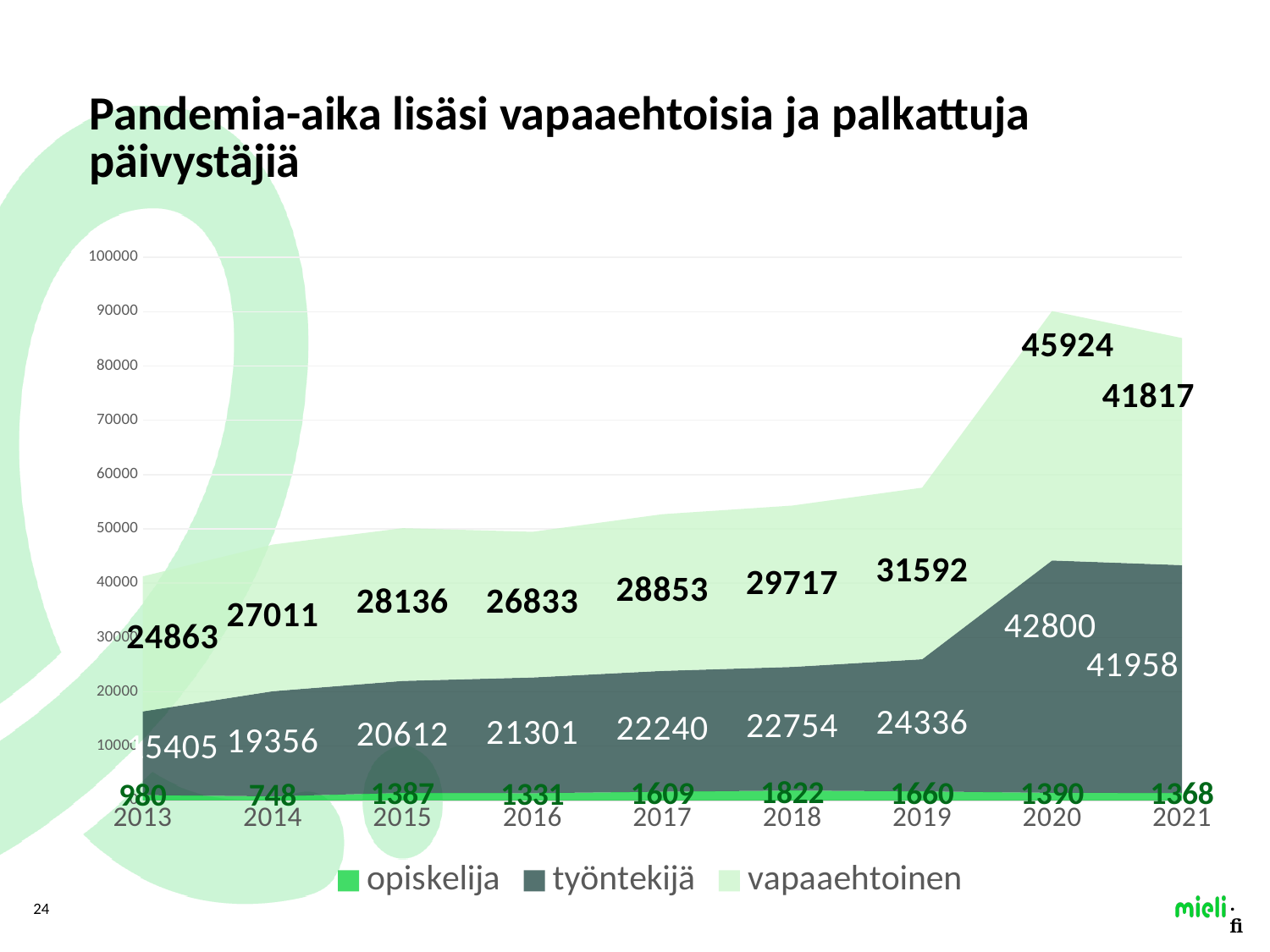
What is the total of the three series in 2021? 85143 What is the value for työntekijä in 2019? 24336 What is the value for opiskelija in 2018? 1822 Which series are listed in the legend? opiskelija, työntekijä, vapaaehtoinen How many series does the legend list? 3 What is the value for vapaaehtoinen in 2020? 45924 In which year is the opiskelija value lowest? 2014 Which year has the larger vapaaehtoinen value, 2015 or 2016? 2015 How many years are shown on the x axis? 9 In which year is the vapaaehtoinen value highest? 2020 What kind of chart is shown on the slide? Stacked area chart By how much did the työntekijä value increase from 2019 to 2020? 18464